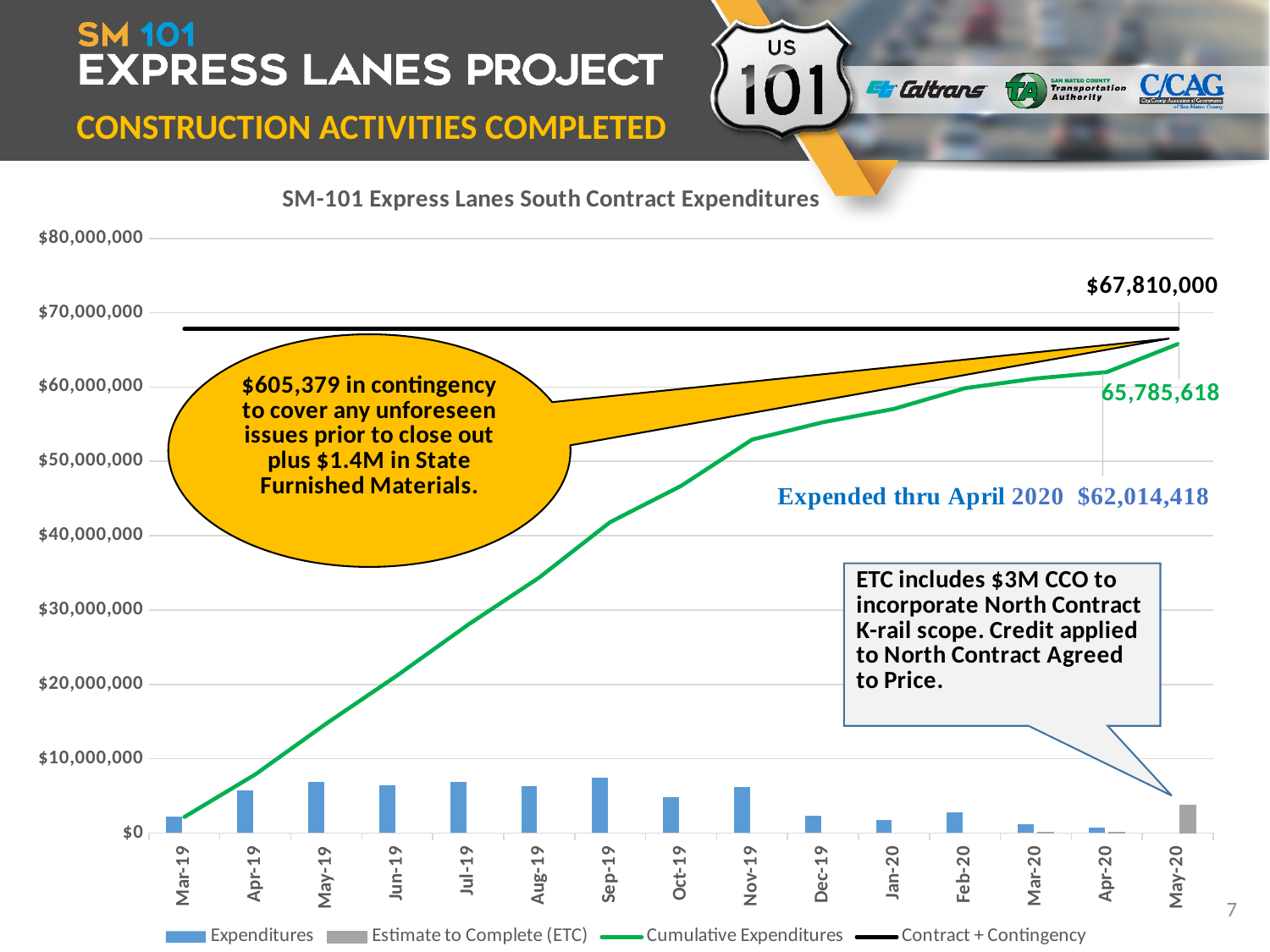
Is the Cumulative Expenditures value at Nov-19 greater or less than $50,000,000? greater Does the Cumulative Expenditures line rise or fall from Mar-19 to May-20? Rise What amount is shown as expended thru April 2020? $62,014,418 What value is labelled for the Contract + Contingency line? $67,810,000 Which month has the lowest Expenditures bar? Apr-20 What kind of chart is shown on the slide? Combined bar and line chart What is the title of the chart? SM-101 Express Lanes South Contract Expenditures How many series does the chart legend list? 4 How many months are shown along the x axis of the chart? 15 What is the final labelled value of the Cumulative Expenditures line at May-20? 65,785,618 Which month has the larger Expenditures bar, Nov-19 or Dec-19? Nov-19 What is the difference between the Contract + Contingency value of $67,810,000 and the final Cumulative Expenditures value of 65,785,618? 2,024,382